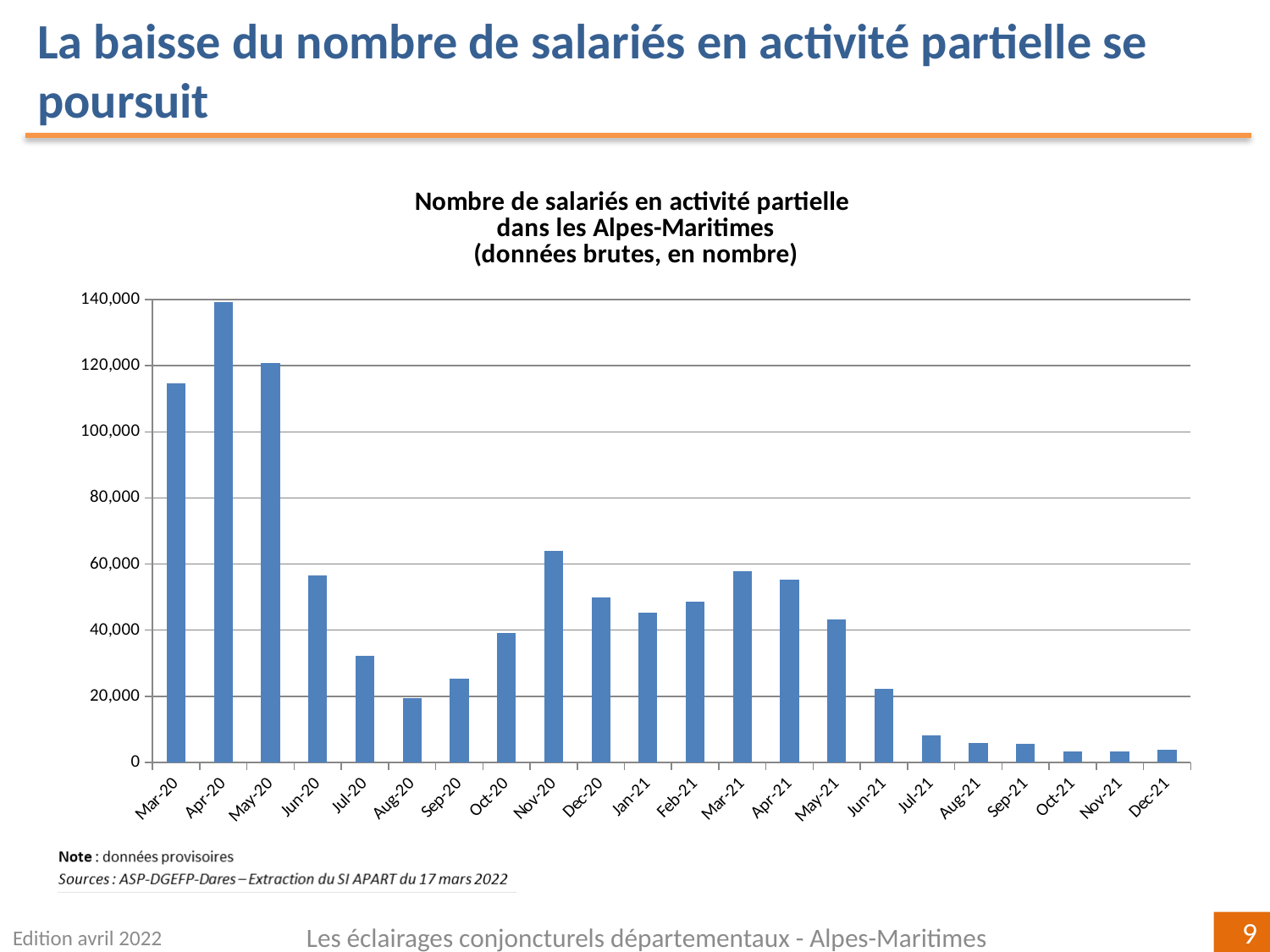
Is the value for Mar-20 greater or less than 100,000? greater Which month has the highest number of salariés en activité partielle? Apr-20 Which is larger, the value for Nov-20 or the value for Dec-20? Nov-20 Is the value for Dec-21 greater or less than 20,000? less Which is larger, the value for Jun-20 or the value for Jul-20? Jun-20 What is the title of the chart? Nombre de salariés en activité partielle dans les Alpes-Maritimes (données brutes, en nombre) Is the value for Jul-21 greater or less than 20,000? less How many months are plotted on the x axis? 22 What kind of chart is shown on the slide? bar chart Overall, do the values rise or fall from Mar-20 to Dec-21? fall